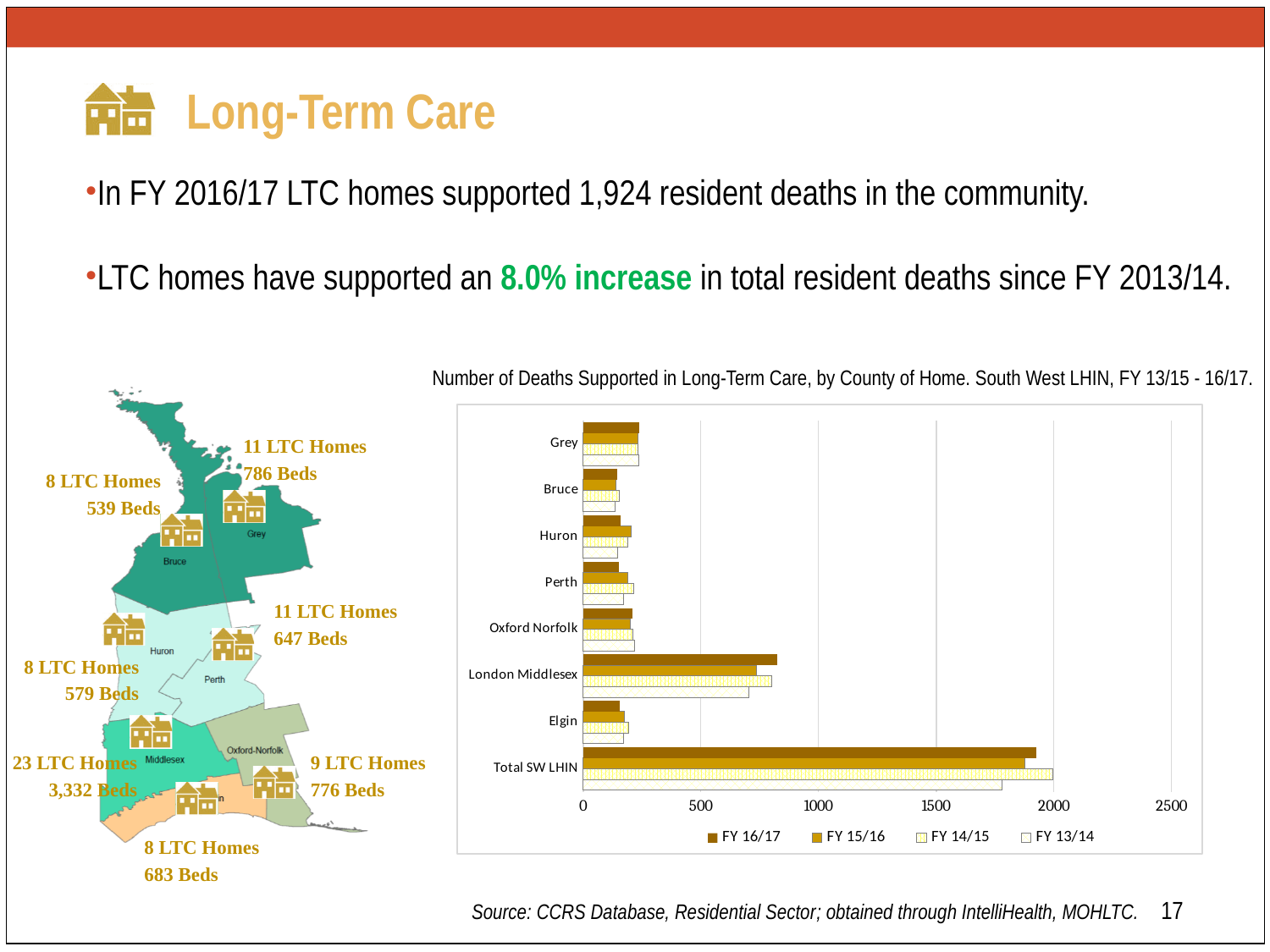
Is the FY 16/17 value for London Middlesex greater or less than 500? greater Is the FY 16/17 value for Total SW LHIN greater or less than 1500? greater Is the FY 16/17 value for Grey greater or less than 500? less What is the title of the chart? Number of Deaths Supported in Long-Term Care, by County of Home. South West LHIN, FY 13/15 - 16/17. How many categories are listed on the vertical axis of the chart? 8 Which fiscal years are listed in the chart's legend? FY 16/17, FY 15/16, FY 14/15, FY 13/14 What kind of chart is shown on the slide? bar chart For FY 16/17, which is larger: the value for London Middlesex or the value for Grey? London Middlesex For FY 16/17, which is larger: the value for Total SW LHIN or the value for London Middlesex? Total SW LHIN Excluding the Total SW LHIN row, which county has the highest FY 16/17 value? London Middlesex How many series does the chart's legend list? 4